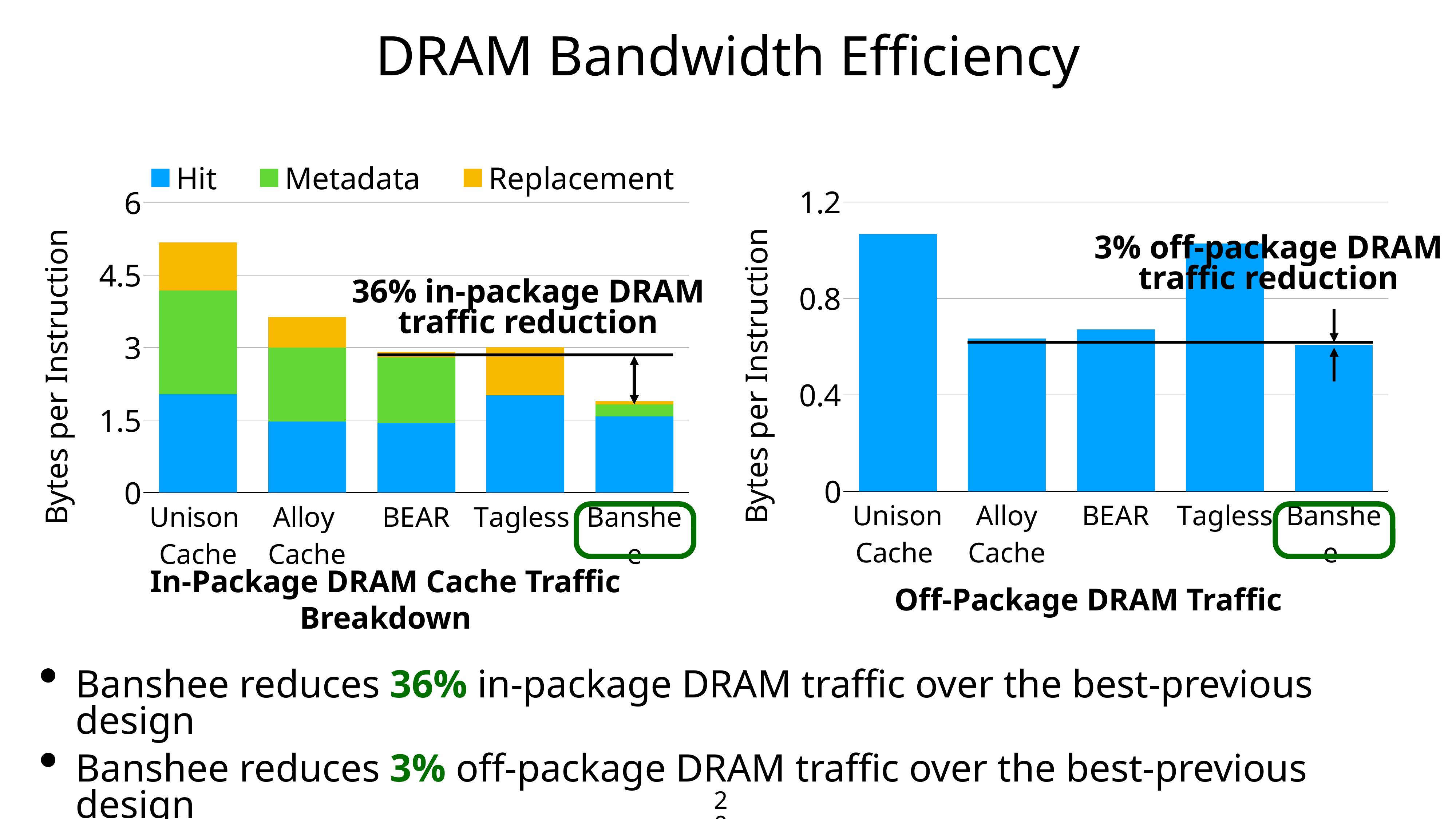
In the In-Package DRAM Cache Traffic Breakdown chart, which design has the highest total bytes per instruction? Unison Cache In the Off-Package DRAM Traffic chart, is the value for Alloy Cache greater or less than 0.8? less In the In-Package DRAM Cache Traffic Breakdown chart, which design has the lowest total bytes per instruction? Banshee In the In-Package DRAM Cache Traffic Breakdown chart, which series is shown in blue? Hit In the In-Package DRAM Cache Traffic Breakdown chart, is the total value for Banshee greater or less than 3? less In the Off-Package DRAM Traffic chart, is the value for Unison Cache greater or less than 0.8? greater How many series does the legend of the In-Package DRAM Cache Traffic Breakdown chart list? 3 In the Off-Package DRAM Traffic chart, which is larger, the value for Unison Cache or the value for BEAR? Unison Cache How many designs are shown on the x axis of the Off-Package DRAM Traffic chart? 5 What kind of chart is the In-Package DRAM Cache Traffic Breakdown chart? stacked bar chart What kind of chart is the Off-Package DRAM Traffic chart? bar chart